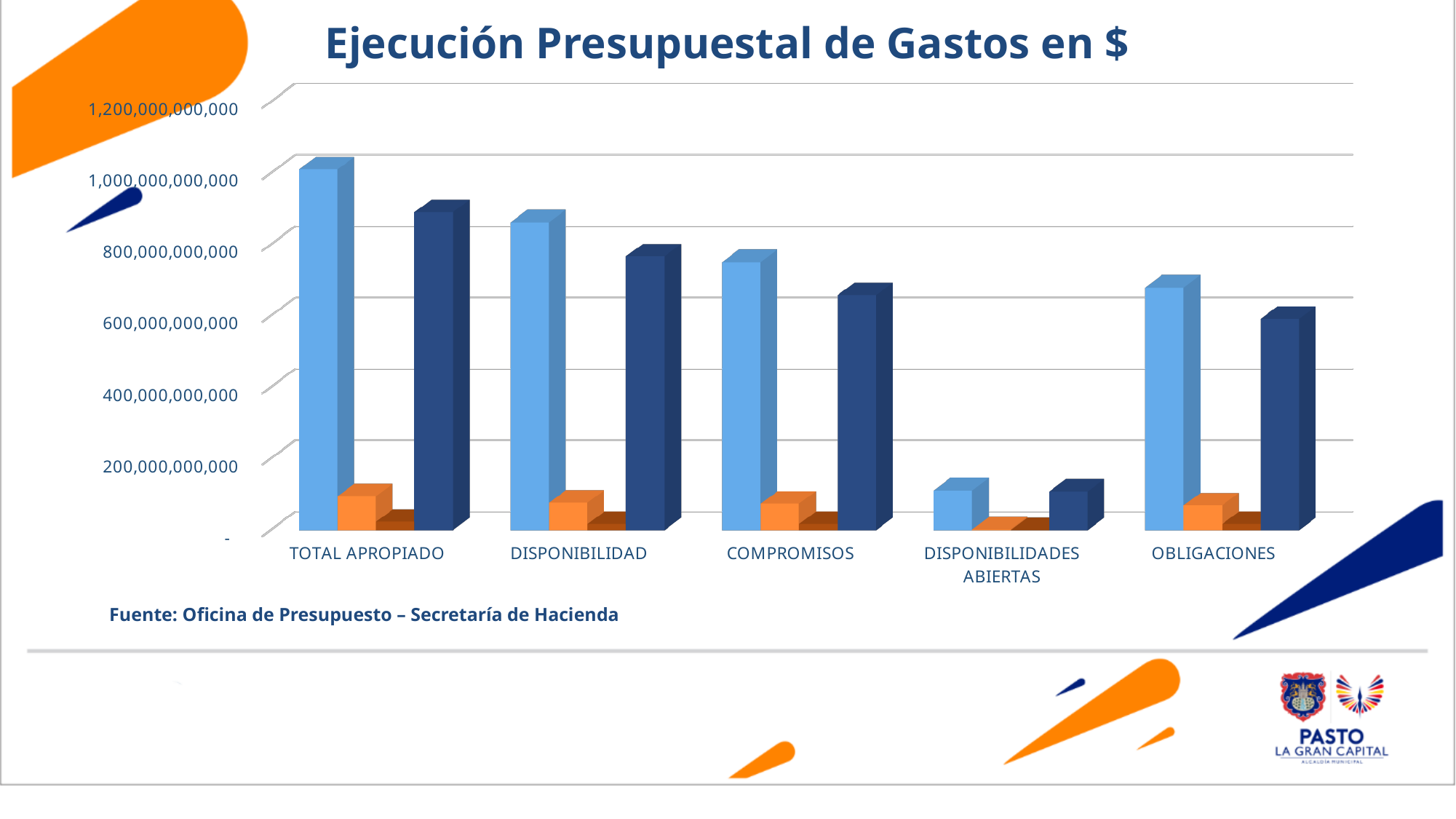
Which category has the tallest light blue bar? TOTAL APROPIADO Is the dark blue bar for DISPONIBILIDAD greater or less than 800,000,000,000? less What type of chart is shown on the slide? bar chart Which category has the shortest light blue bar? DISPONIBILIDADES ABIERTAS Is the light blue bar for COMPROMISOS greater or less than 800,000,000,000? less Which category has the shortest dark blue bar? DISPONIBILIDADES ABIERTAS Which is larger: the light blue bar for OBLIGACIONES or the light blue bar for DISPONIBILIDADES ABIERTAS? OBLIGACIONES What is the title of the chart? Ejecución Presupuestal de Gastos en $ Is the light blue bar for DISPONIBILIDADES ABIERTAS greater or less than 200,000,000,000? less For TOTAL APROPIADO, which is larger: the light blue bar or the dark blue bar? the light blue bar How many categories are shown on the x axis of the chart? 5